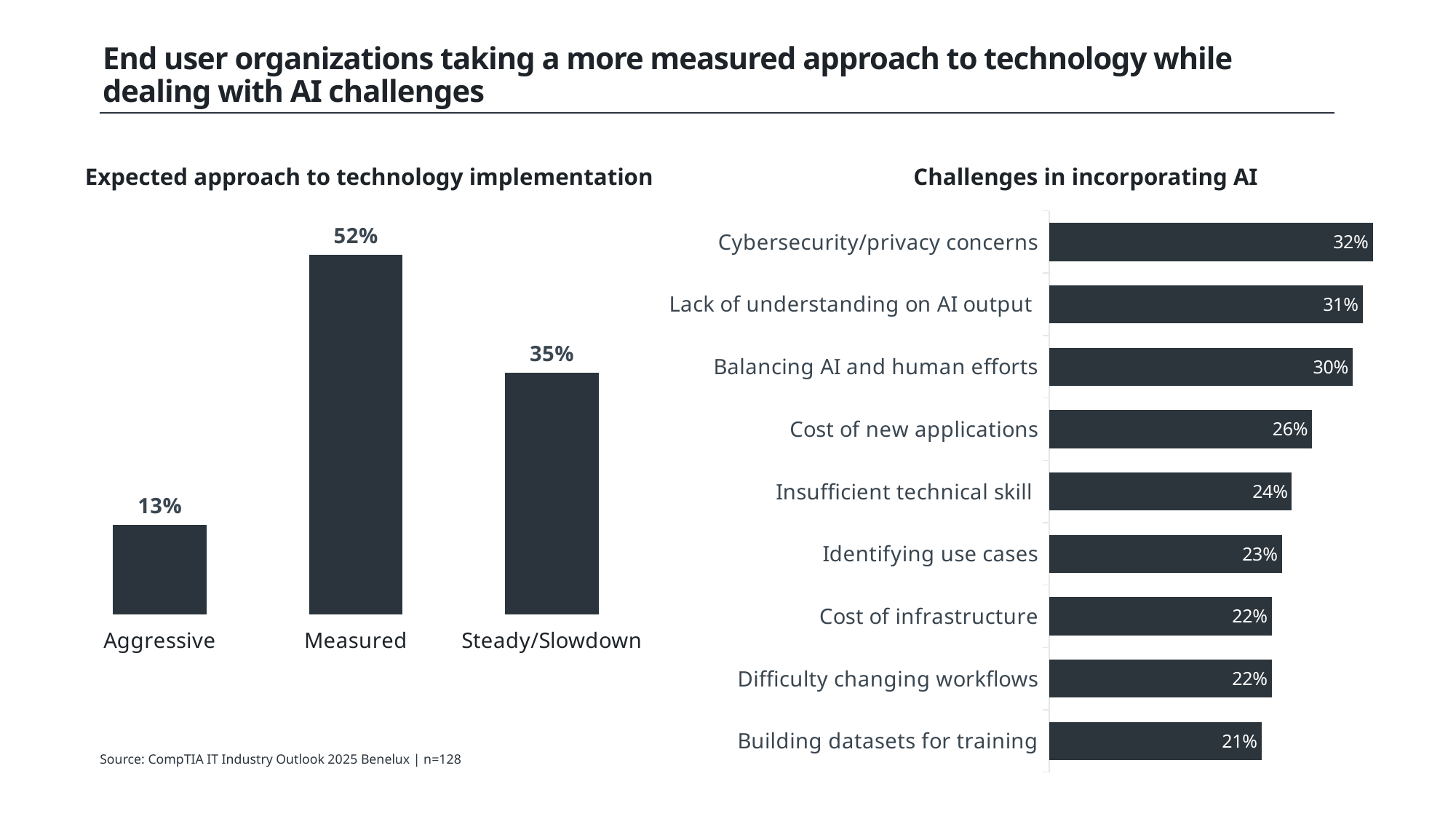
In the 'Challenges in incorporating AI' chart, how many challenges are listed? 9 In the 'Expected approach to technology implementation' chart, which category has the lowest value? Aggressive In the 'Expected approach to technology implementation' chart, what is the difference between Measured and Steady/Slowdown? 17% In the 'Expected approach to technology implementation' chart, what is the value for Measured? 52% In the 'Challenges in incorporating AI' chart, what is the difference between Cybersecurity/privacy concerns and Balancing AI and human efforts? 2% In the 'Challenges in incorporating AI' chart, what is the value for Cost of new applications? 26% In the 'Challenges in incorporating AI' chart, which is larger: Insufficient technical skill or Identifying use cases? Insufficient technical skill What is the title of the chart on the left side of the slide? Expected approach to technology implementation In the 'Challenges in incorporating AI' chart, which challenge has the highest value? Cybersecurity/privacy concerns In the 'Challenges in incorporating AI' chart, which challenge has the lowest value? Building datasets for training In the 'Expected approach to technology implementation' chart, how many categories are shown? 3 What kind of chart is the 'Challenges in incorporating AI' chart? Bar chart